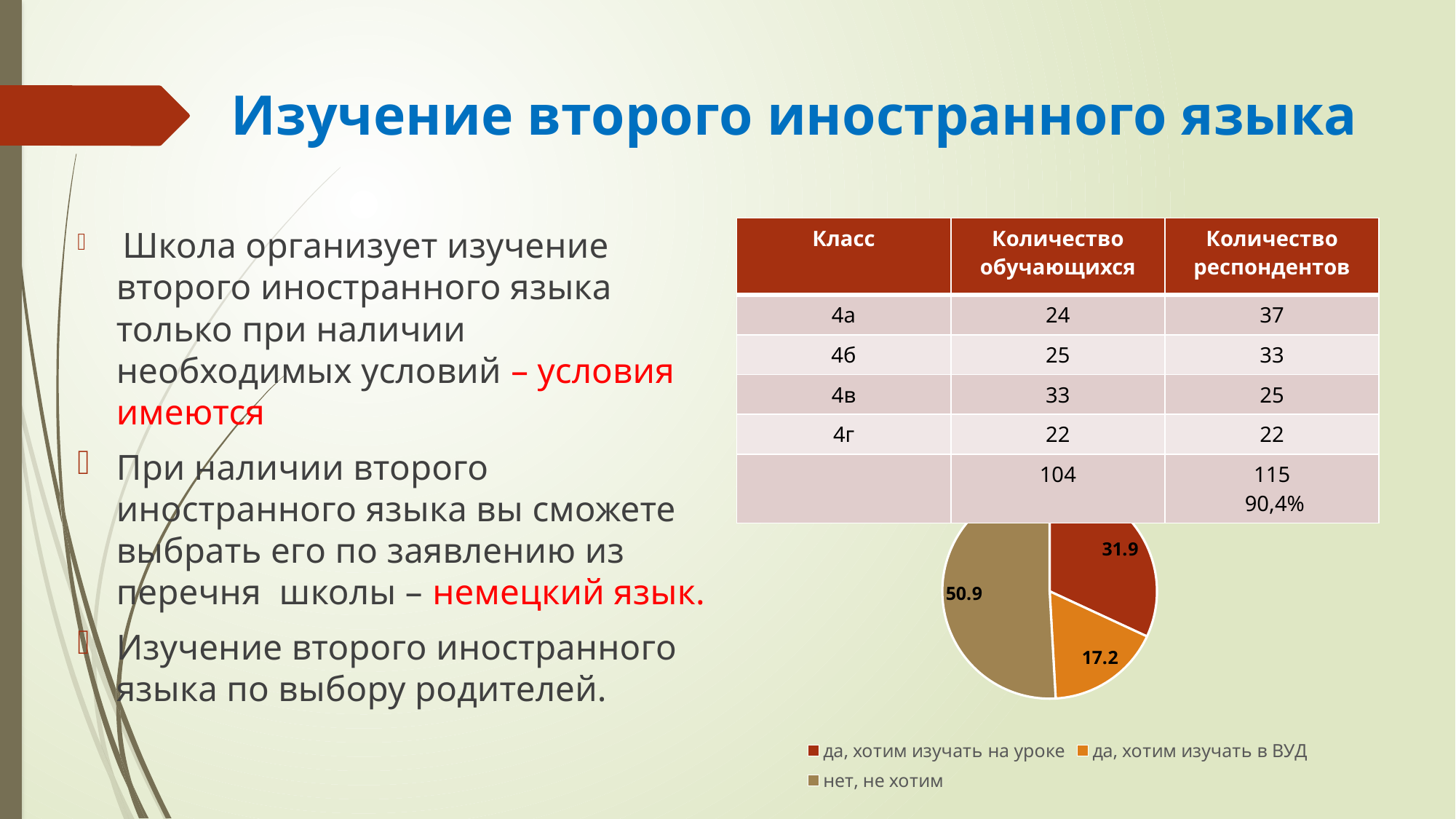
How many slices does the pie chart have? 3 What is the value for "нет, не хотим" in the pie chart? 50.9 What colour is the slice for "нет, не хотим" in the pie chart? brown (tan) Which is larger in the pie chart: "да, хотим изучать на уроке" or "да, хотим изучать в ВУД"? да, хотим изучать на уроке What is the difference between the values for "да, хотим изучать на уроке" and "да, хотим изучать в ВУД" in the pie chart? 14.7 What kind of chart is shown on the slide? pie chart Which category has the largest slice in the pie chart? нет, не хотим Which category has the smallest slice in the pie chart? да, хотим изучать в ВУД What is the difference between the values for "нет, не хотим" and "да, хотим изучать на уроке" in the pie chart? 19 What is the value for "да, хотим изучать на уроке" in the pie chart? 31.9 What is the value for "да, хотим изучать в ВУД" in the pie chart? 17.2 How many entries does the pie chart legend list? 3